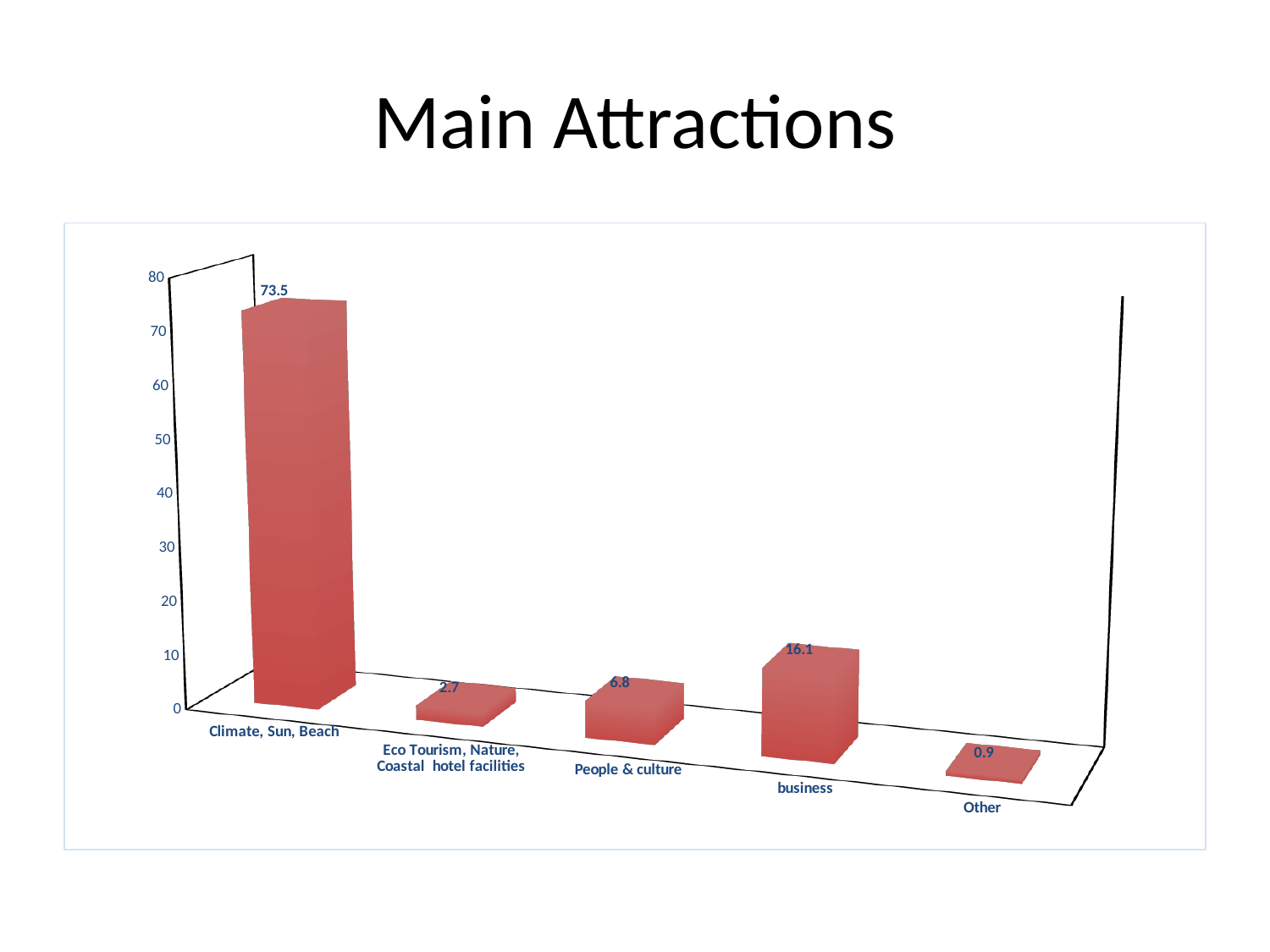
What kind of chart is shown on the slide? bar chart What is the value for Other? 0.9 What is the title of the slide? Main Attractions What is the difference between the values for Climate, Sun, Beach and business? 57.4 Which is larger, the value for People & culture or the value for Eco Tourism, Nature, Coastal hotel facilities? People & culture Which category has the lowest value? Other What is the value for Climate, Sun, Beach? 73.5 Is the value for business greater or less than 20? less Which category has the highest value? Climate, Sun, Beach How many categories are shown in the chart? 5 What is the value for People & culture? 6.8 What is the value for business? 16.1